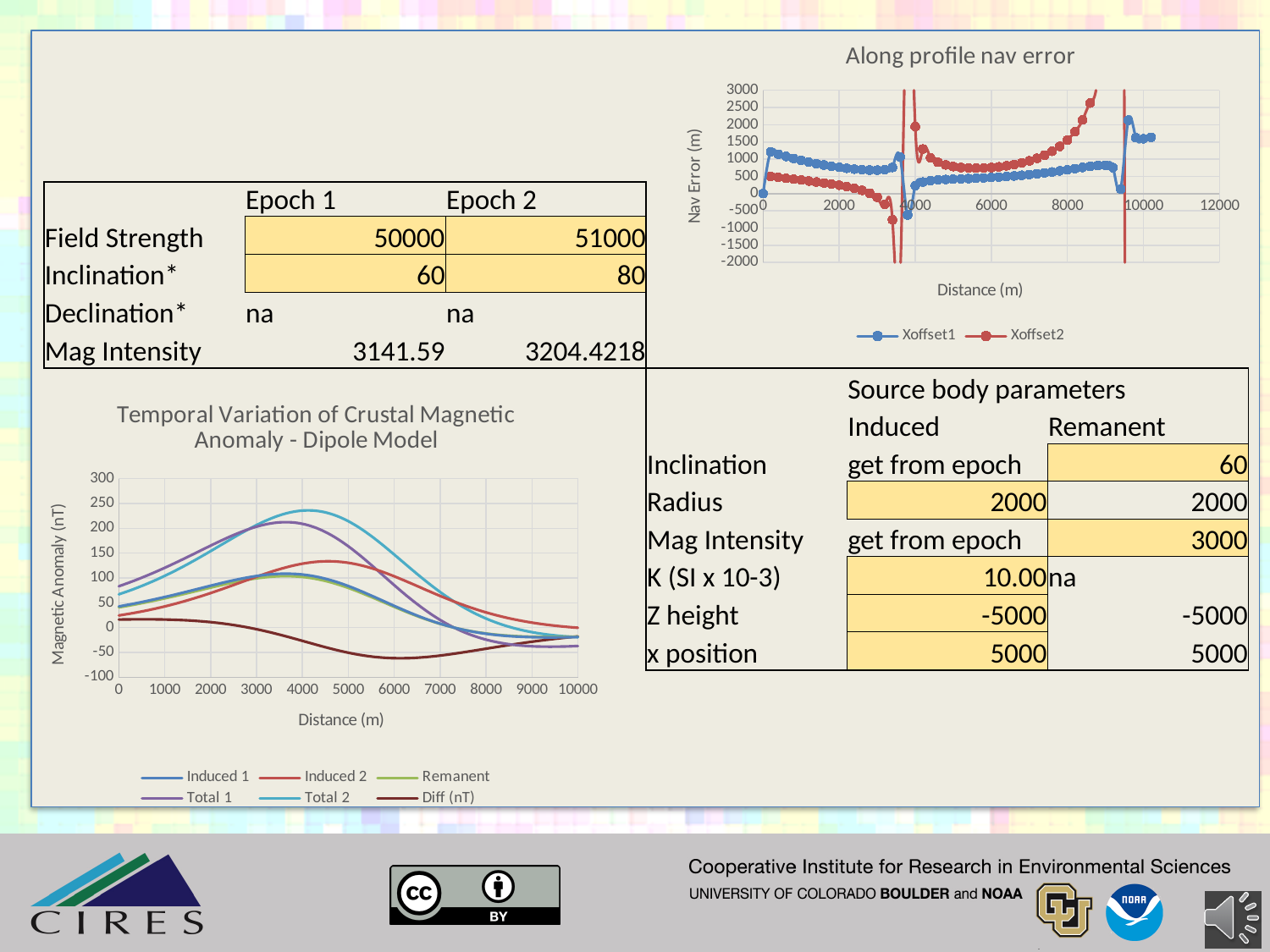
In the 'Along profile nav error' chart, does the Xoffset2 series rise or fall between distances 6000 and 8500? rise What type of chart is the 'Temporal Variation of Crustal Magnetic Anomaly - Dipole Model' chart? line chart In the 'Temporal Variation of Crustal Magnetic Anomaly - Dipole Model' chart, is the Diff (nT) value at a distance of 6000 greater or less than 0? less How many series does the legend of the 'Along profile nav error' chart list? 2 How many series does the legend of the 'Temporal Variation of Crustal Magnetic Anomaly - Dipole Model' chart list? 6 In the 'Along profile nav error' chart, which series has the larger value at a distance of 2000, Xoffset1 or Xoffset2? Xoffset1 In the 'Along profile nav error' chart, is the Xoffset1 value at a distance of 2000 greater or less than 500? greater In the 'Temporal Variation of Crustal Magnetic Anomaly - Dipole Model' chart, which series reaches the highest peak value? Total 2 What type of chart is the 'Along profile nav error' chart? line chart In the 'Along profile nav error' chart, what is the label of the y axis? Nav Error (m) In the 'Along profile nav error' chart, is the Xoffset2 value at a distance of 2000 greater or less than 500? less